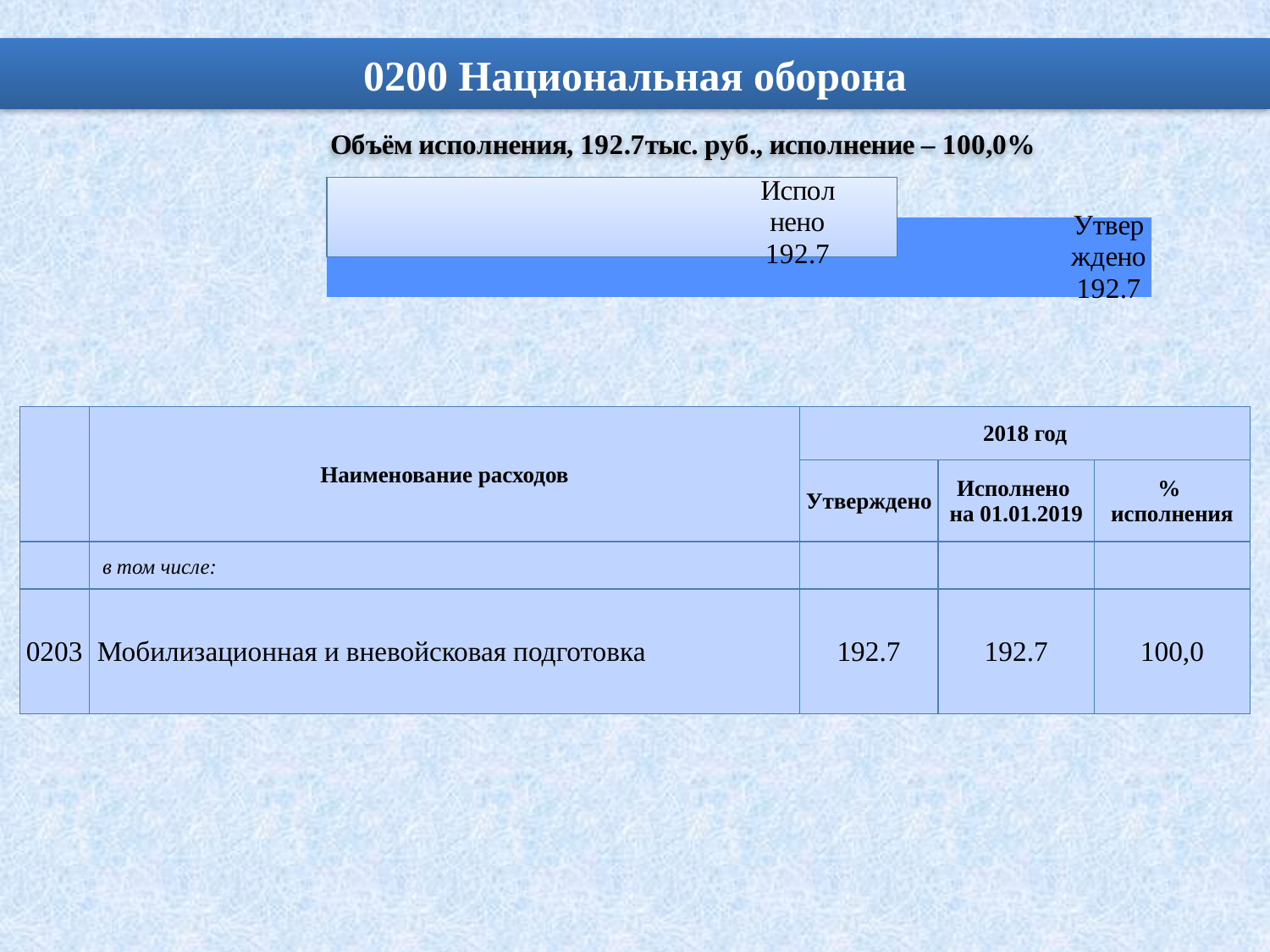
What value is shown for the Исполнено bar in the chart? 192.7 What value is shown for the Утверждено bar in the chart? 192.7 Which bar in the chart is coloured bright blue, Исполнено or Утверждено? Утверждено How many bars does the chart contain? 2 Are the bars in the chart drawn horizontally or vertically? horizontally What kind of chart is shown on the slide? bar chart What is the difference between the Утверждено value and the Исполнено value in the chart? 0.0